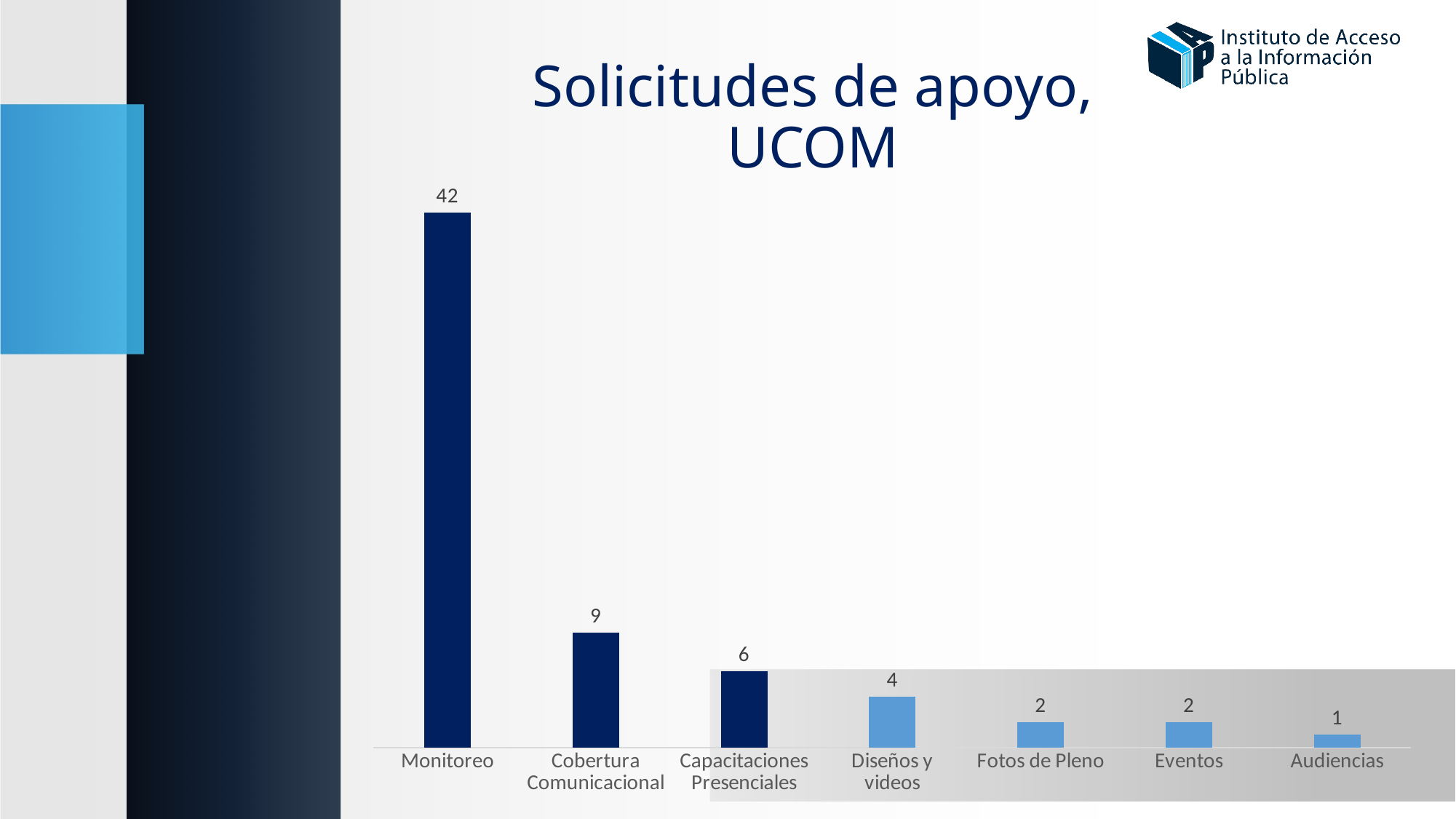
Which category has the lowest value? Audiencias What is the title of the slide? Solicitudes de apoyo, UCOM What is the difference between the values for Monitoreo and Cobertura Comunicacional? 33 How many categories are shown in the chart? 7 What is the value for Capacitaciones Presenciales? 6 What is the value for Audiencias? 1 Which category has the highest value? Monitoreo What is the value for Monitoreo? 42 What kind of chart is shown on the slide? Bar chart What is the value for Diseños y videos? 4 Which is larger, the value for Capacitaciones Presenciales or the value for Diseños y videos? Capacitaciones Presenciales What is the value for Cobertura Comunicacional? 9